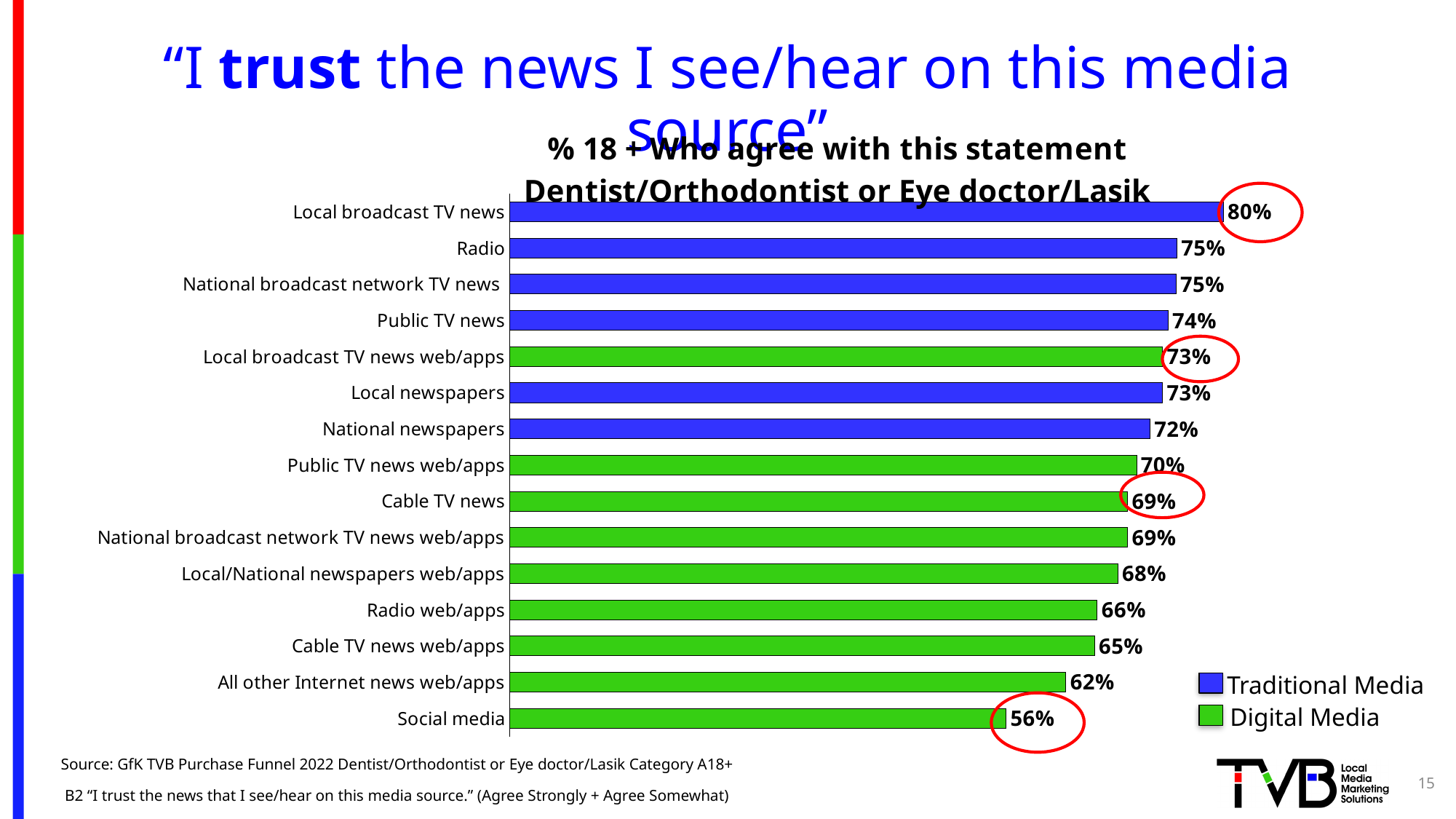
How many series does the legend list? 2 What type of chart is shown on the slide? Bar chart What is the value for Local broadcast TV news web/apps? 73% Which media source has the highest percentage of agreement? Local broadcast TV news Which has a higher value: Radio or Radio web/apps? Radio What percentage is shown for Cable TV news? 69% What is the value shown for Social media? 56% What is the difference in percentage points between Local broadcast TV news and Social media? 24 What percentage of adults 18+ agree they trust the news on Local broadcast TV news? 80% Which media source has the lowest percentage of agreement? Social media Which colour represents Digital Media in the legend? Green How many media sources are shown in the chart? 15